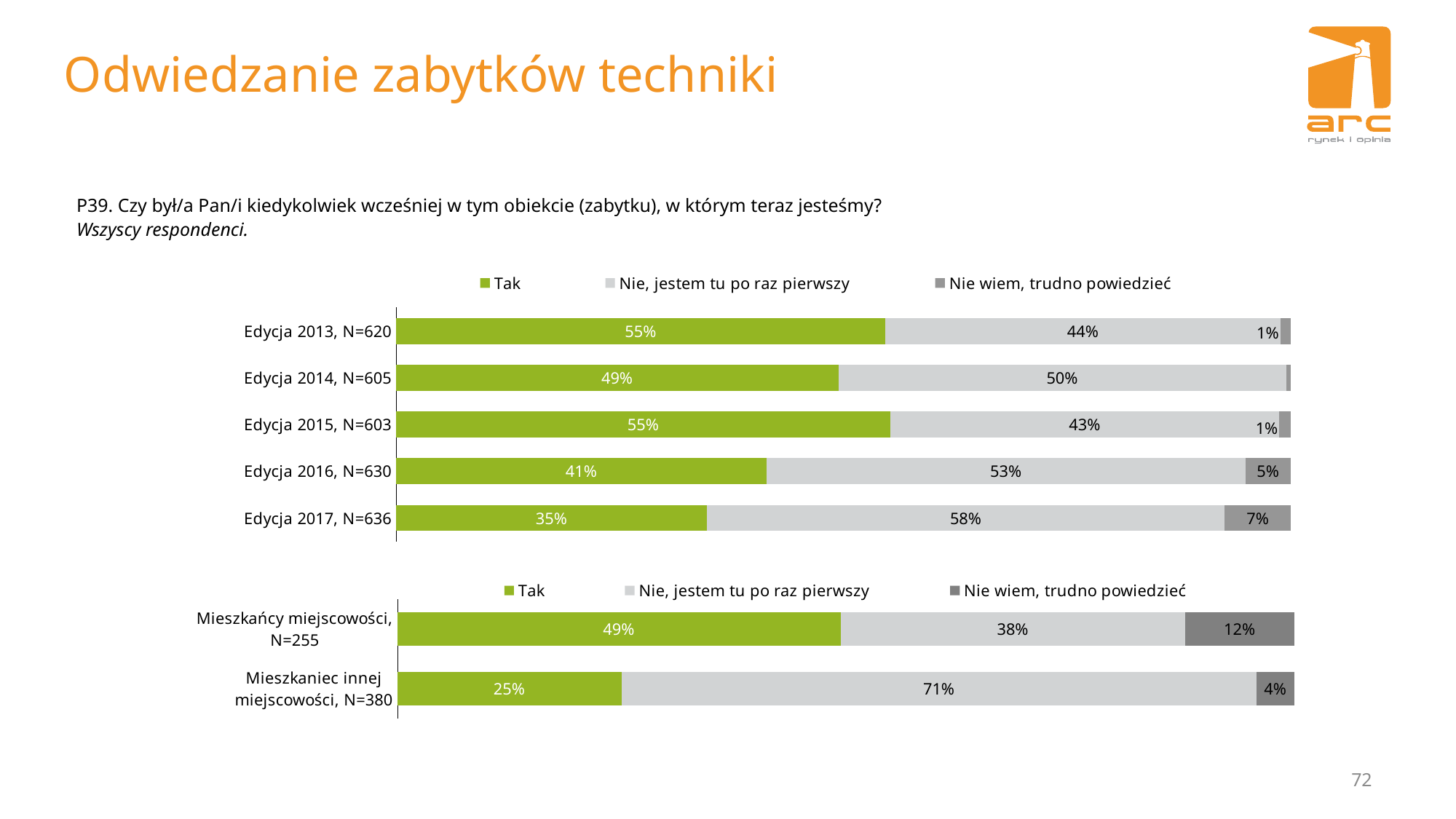
In the top chart, which edition has the highest 'Nie, jestem tu po raz pierwszy' value? Edycja 2017, N=636 In the top chart, what is the difference between the 'Tak' values for Edycja 2013, N=620 and Edycja 2017, N=636? 20% In the top chart, what is the 'Nie wiem, trudno powiedzieć' value for Edycja 2016, N=630? 5% In the bottom chart, which group has the larger 'Nie, jestem tu po raz pierwszy' value? Mieszkaniec innej miejscowości, N=380 In the top chart, what is the 'Tak' value for Edycja 2017, N=636? 35% In the bottom chart, what is the 'Nie wiem, trudno powiedzieć' value for Mieszkańcy miejscowości, N=255? 12% In the top chart, which edition has the lowest 'Tak' value? Edycja 2017, N=636 How many series does the legend of the bottom chart list? 3 In the top chart, does the 'Tak' value rise or fall from Edycja 2015 to Edycja 2017? fall In the top chart, what is the 'Nie, jestem tu po raz pierwszy' value for Edycja 2014, N=605? 50% In the bottom chart, what is the 'Tak' value for Mieszkaniec innej miejscowości, N=380? 25% In the top chart, how many editions are shown? 5